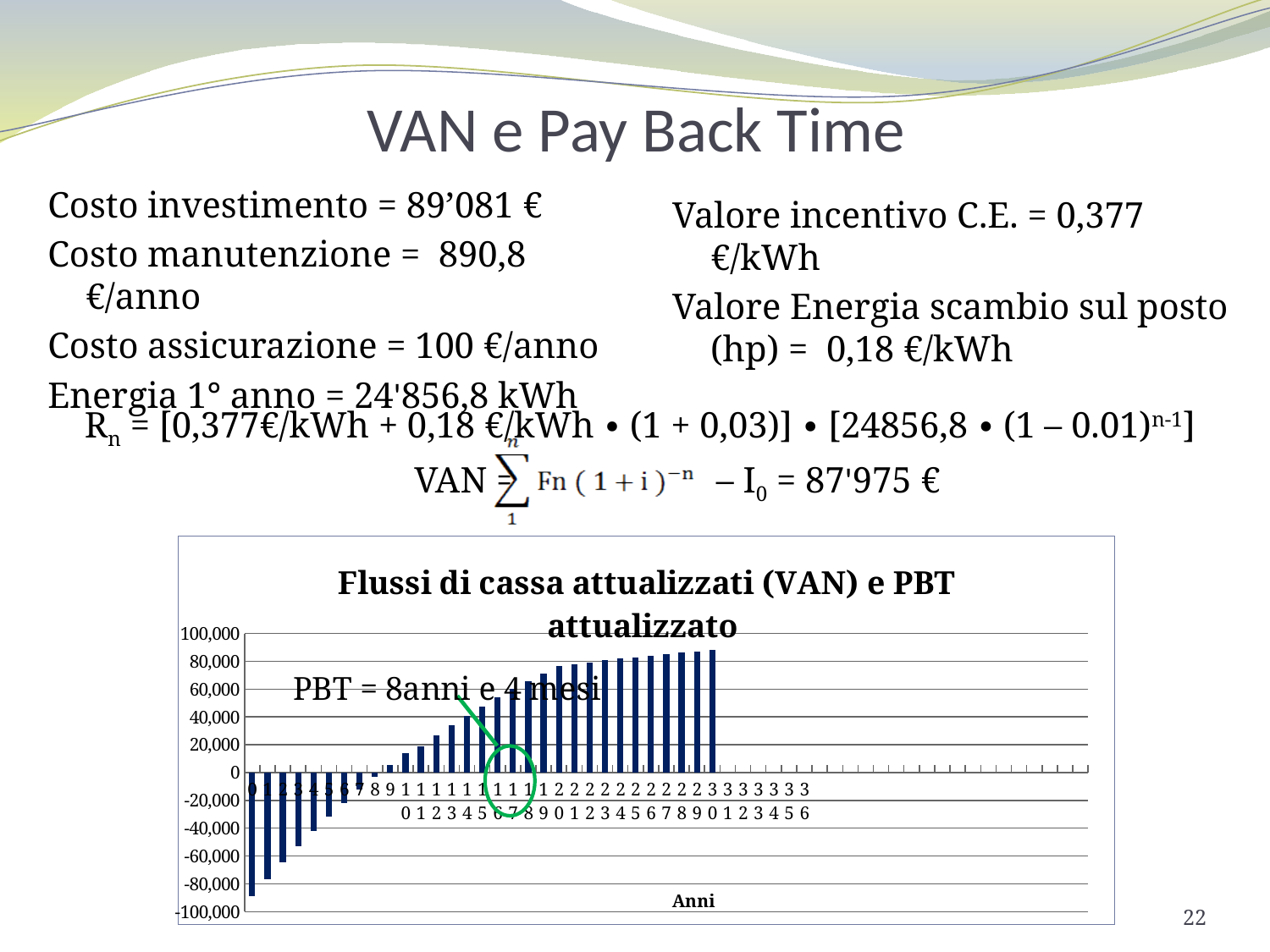
What is the title of the chart? Flussi di cassa attualizzati (VAN) e PBT attualizzato Is the value for year 30 greater or less than 60,000? greater Which is larger, the value for year 2 or the value for year 20? year 20 Do the values in the chart rise or fall as the years increase along the x axis? rise Is the value for year 5 greater or less than 0? less What is the label of the x axis of the chart? Anni What kind of chart is shown on the slide? bar chart Is the value for year 12 greater or less than 0? greater How many years (bars) are plotted in the chart? 31 Which year has the lowest value in the chart? 0